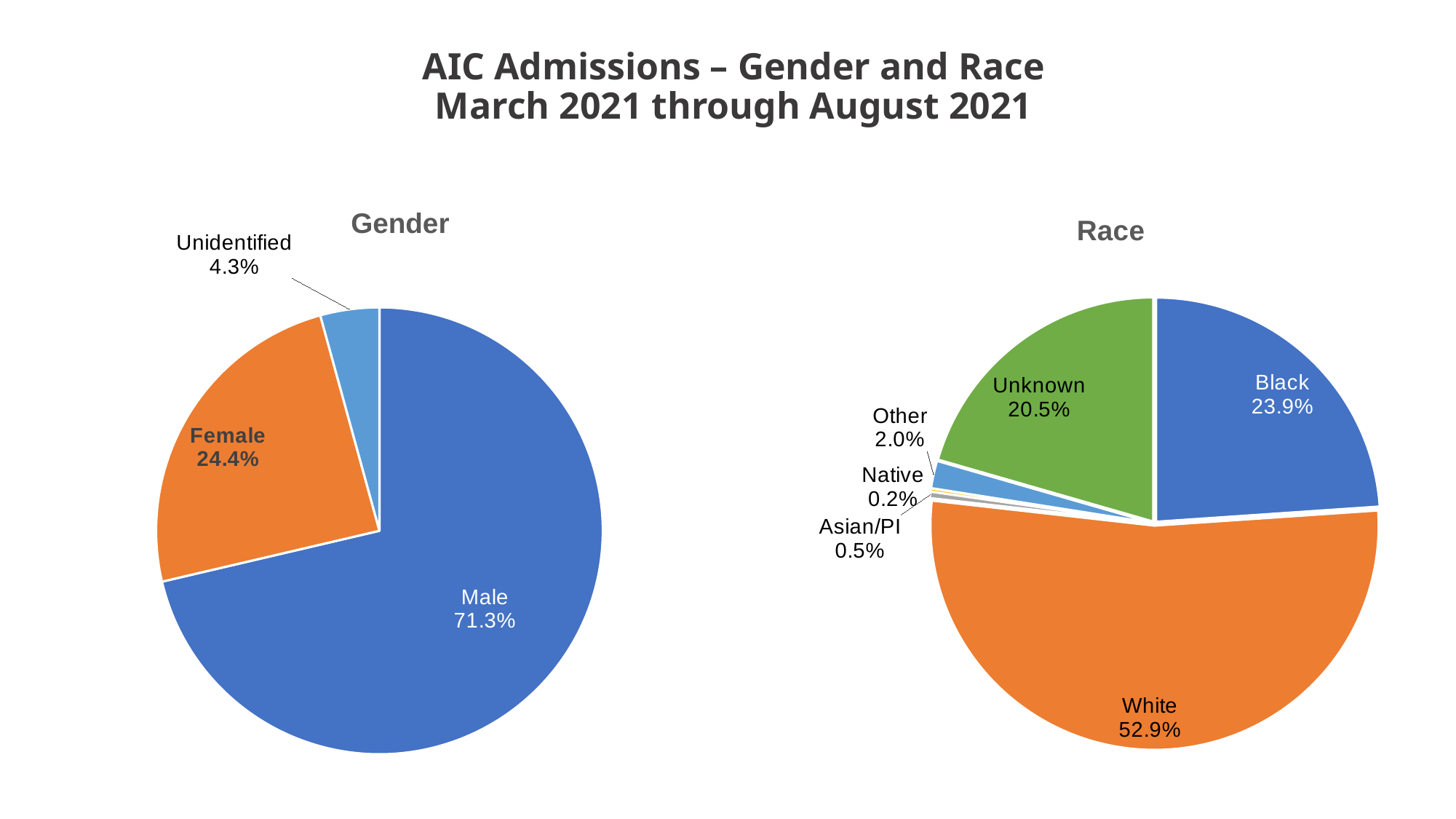
In the Race pie chart, which category has the smallest share? Native In the Gender pie chart, what percentage of admissions is Male? 71.3% How many categories does the Race pie chart show? 6 In the Race pie chart, what is the value for Unknown? 20.5% In the Gender pie chart, what is the difference in percentage points between Male and Female? 46.9 In the Race pie chart, what percentage of admissions is White? 52.9% In the Gender pie chart, what is the value for Unidentified? 4.3% What type of chart is the Gender chart? Pie chart In the Gender pie chart, what percentage of admissions is Female? 24.4% In the Race pie chart, what is the value for Native? 0.2% In the Race pie chart, which category has the largest share? White In the Race pie chart, which is larger, Black or Unknown? Black